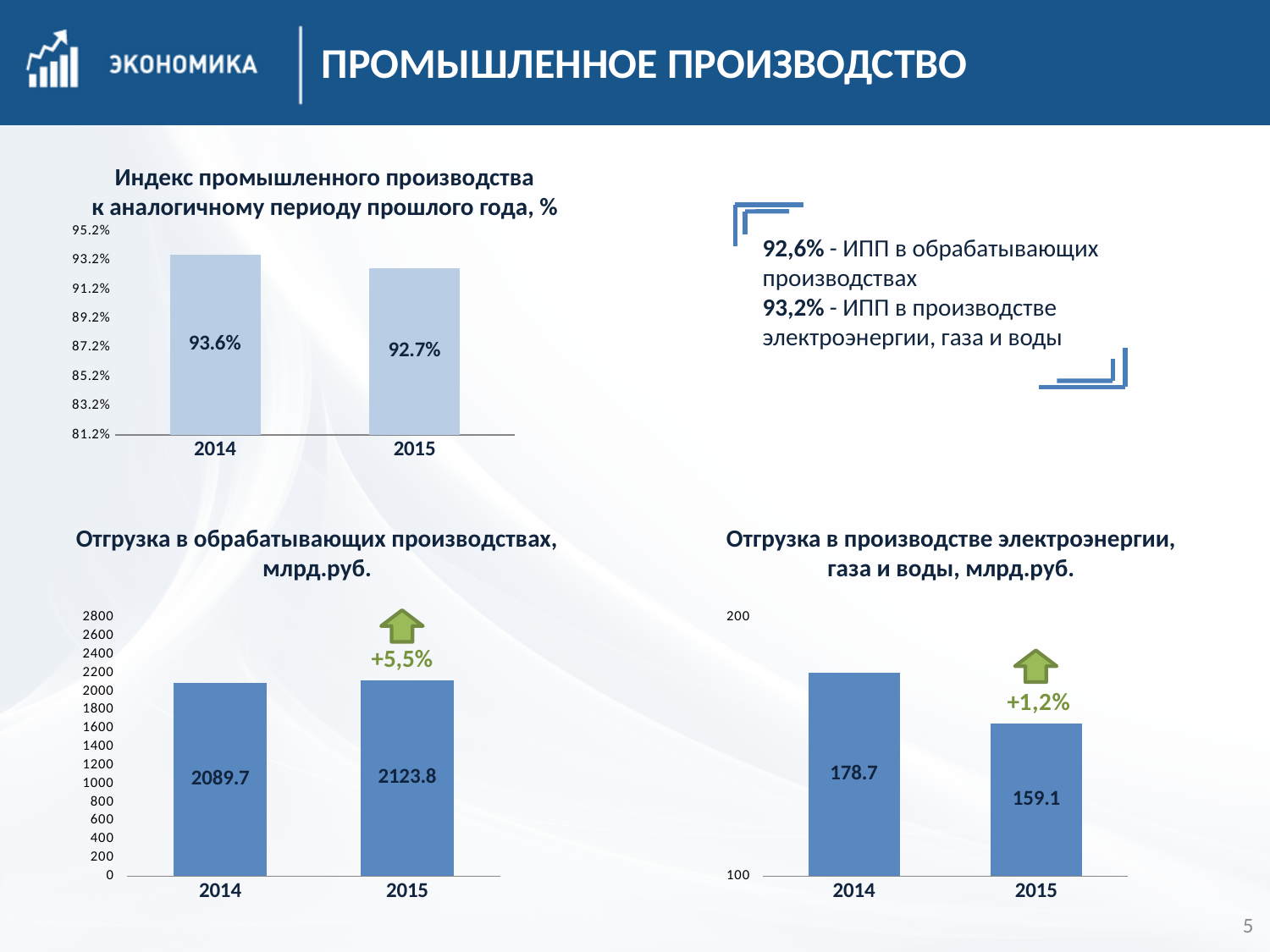
In the chart 'Отгрузка в обрабатывающих производствах, млрд.руб.', do the values rise or fall from 2014 to 2015? rise In the chart 'Отгрузка в обрабатывающих производствах, млрд.руб.', what is the difference between the 2015 and 2014 values? 34.1 In the chart 'Индекс промышленного производства к аналогичному периоду прошлого года, %', which year has the higher value? 2014 In the chart 'Индекс промышленного производства к аналогичному периоду прошлого года, %', what is the value for 2015? 92.7% In the chart 'Отгрузка в обрабатывающих производствах, млрд.руб.', what is the value for 2014? 2089.7 What kind of chart is 'Отгрузка в производстве электроэнергии, газа и воды, млрд.руб.'? bar chart In the chart 'Индекс промышленного производства к аналогичному периоду прошлого года, %', what is the value for 2014? 93.6% In the chart 'Отгрузка в производстве электроэнергии, газа и воды, млрд.руб.', what is the value for 2015? 159.1 In the chart 'Отгрузка в производстве электроэнергии, газа и воды, млрд.руб.', what is the value for 2014? 178.7 In the chart 'Отгрузка в обрабатывающих производствах, млрд.руб.', what is the value for 2015? 2123.8 In the chart 'Индекс промышленного производства к аналогичному периоду прошлого года, %', by how much does the value for 2014 exceed the value for 2015? 0.9% In the chart 'Отгрузка в производстве электроэнергии, газа и воды, млрд.руб.', which year has the lower value? 2015